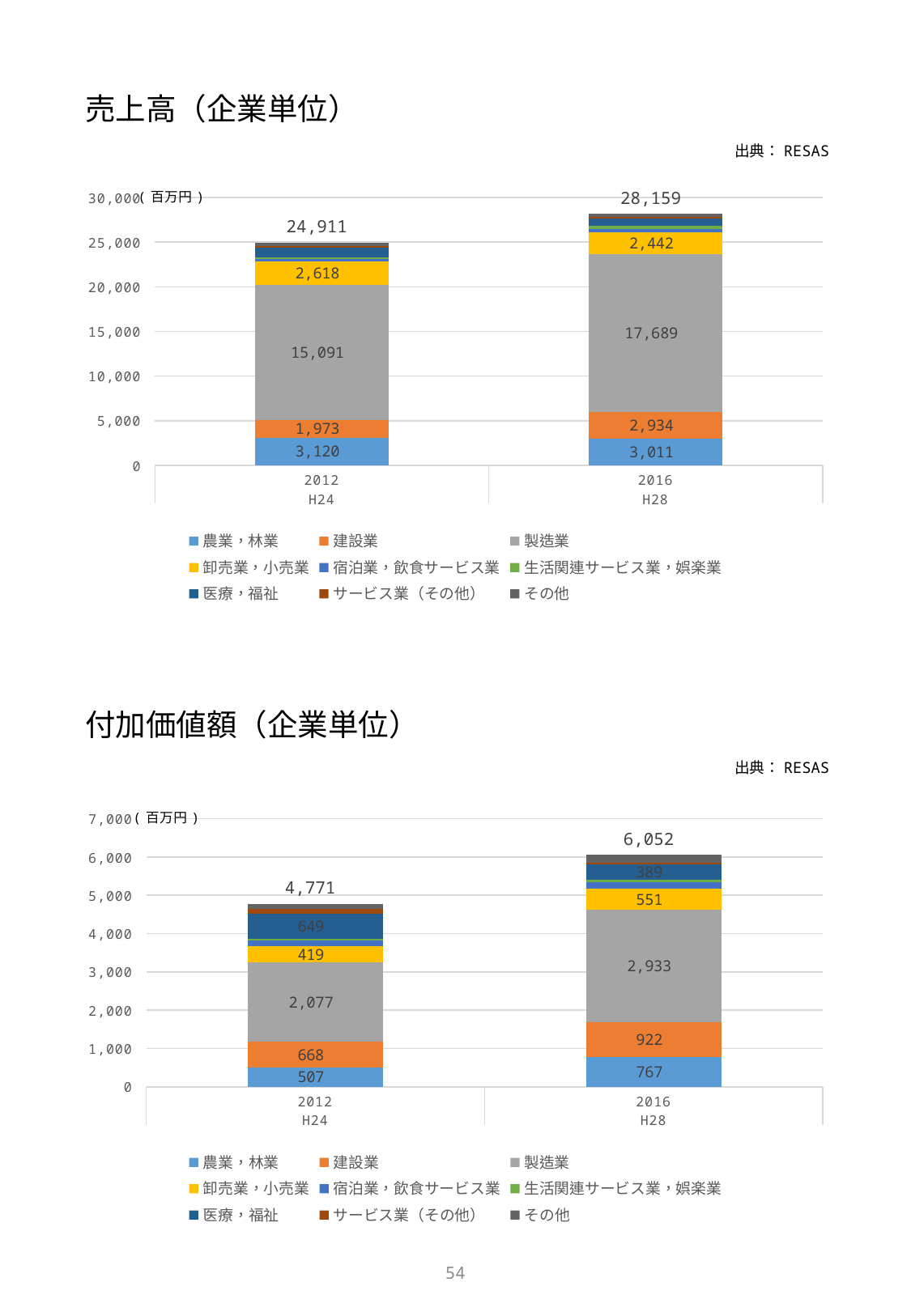
In the 売上高（企業単位） chart, what is the value for 建設業 in 2016 (H28)? 2,934 In the 売上高（企業単位） chart, what is the total sales value for 2016 (H28)? 28,159 In the 売上高（企業単位） chart, which year has the larger value for 卸売業，小売業, 2012 or 2016? 2012 In the 付加価値額（企業単位） chart, what is the difference between the 製造業 values for 2016 and 2012? 856 In the 売上高（企業単位） chart, by how much did the 製造業 value change from 2012 to 2016? 2,598 What kind of chart is the 付加価値額（企業単位） chart? stacked bar chart In the 付加価値額（企業単位） chart, what is the value for 医療，福祉 in 2012 (H24)? 649 In the 付加価値額（企業単位） chart, what is the value for 農業，林業 in 2016 (H28)? 767 How many series does the legend of the 売上高（企業単位） chart list? 9 In the 付加価値額（企業単位） chart, what is the total for 2012 (H24)? 4,771 In the 売上高（企業単位） chart, what is the value for 製造業 in 2012 (H24)? 15,091 In the 売上高（企業単位） chart, does the total for 2012 rise or fall by 2016? rise